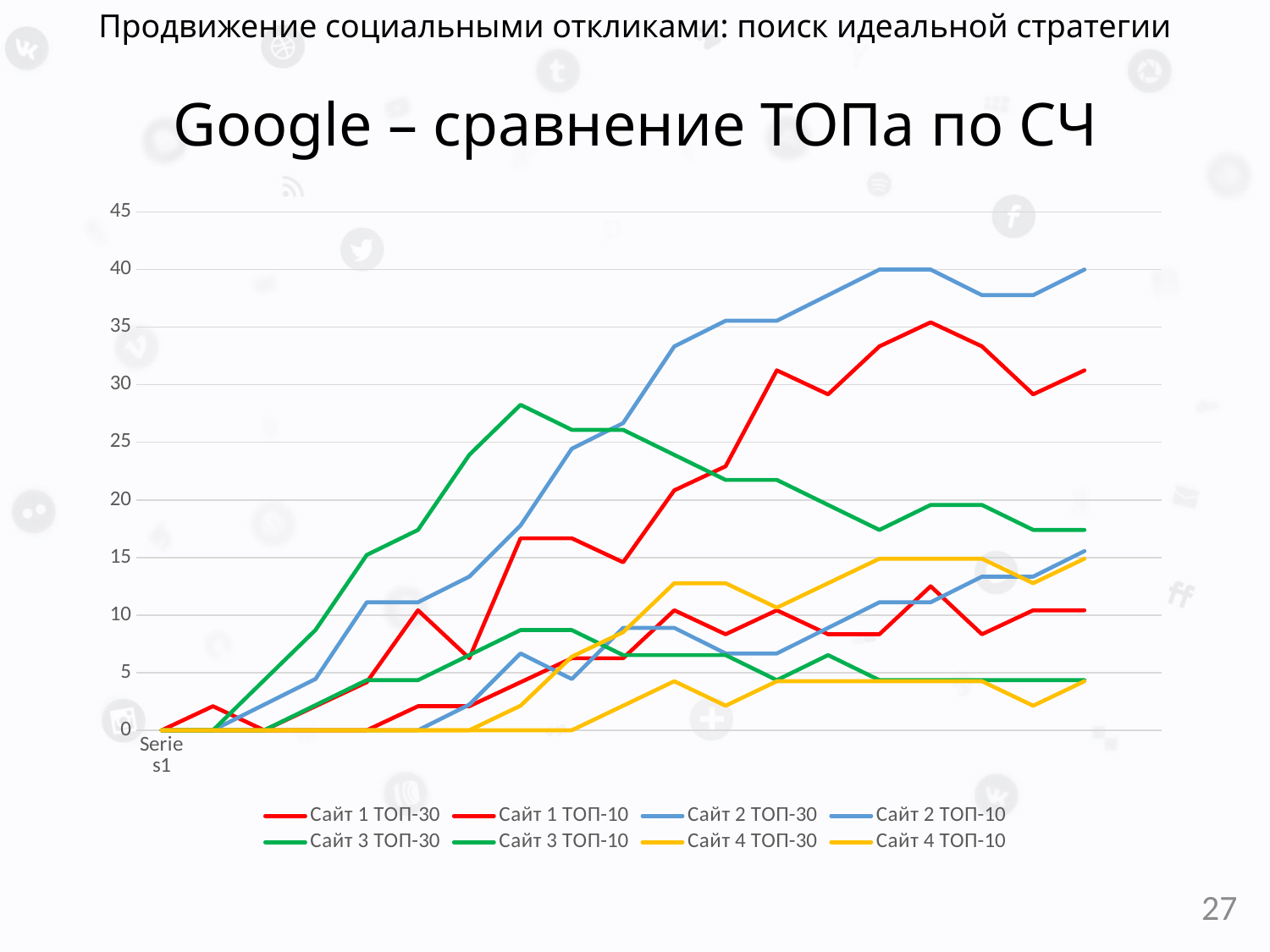
How many different sites (Сайт) are named in the legend? 4 Do the lines on the chart generally rise or fall from left to right? rise What is the highest tick value shown on the vertical axis? 45 Which colour of line reaches the highest value on the chart? blue What is the title of the chart? Google – сравнение ТОПа по СЧ Is the highest point reached by the green lines greater or less than 25? greater Is the highest point reached by any line on the chart greater or less than 45? less What kind of chart is shown on the slide? line chart Is the highest point reached by any line on the chart greater or less than 35? greater How many series does the chart legend list? 8